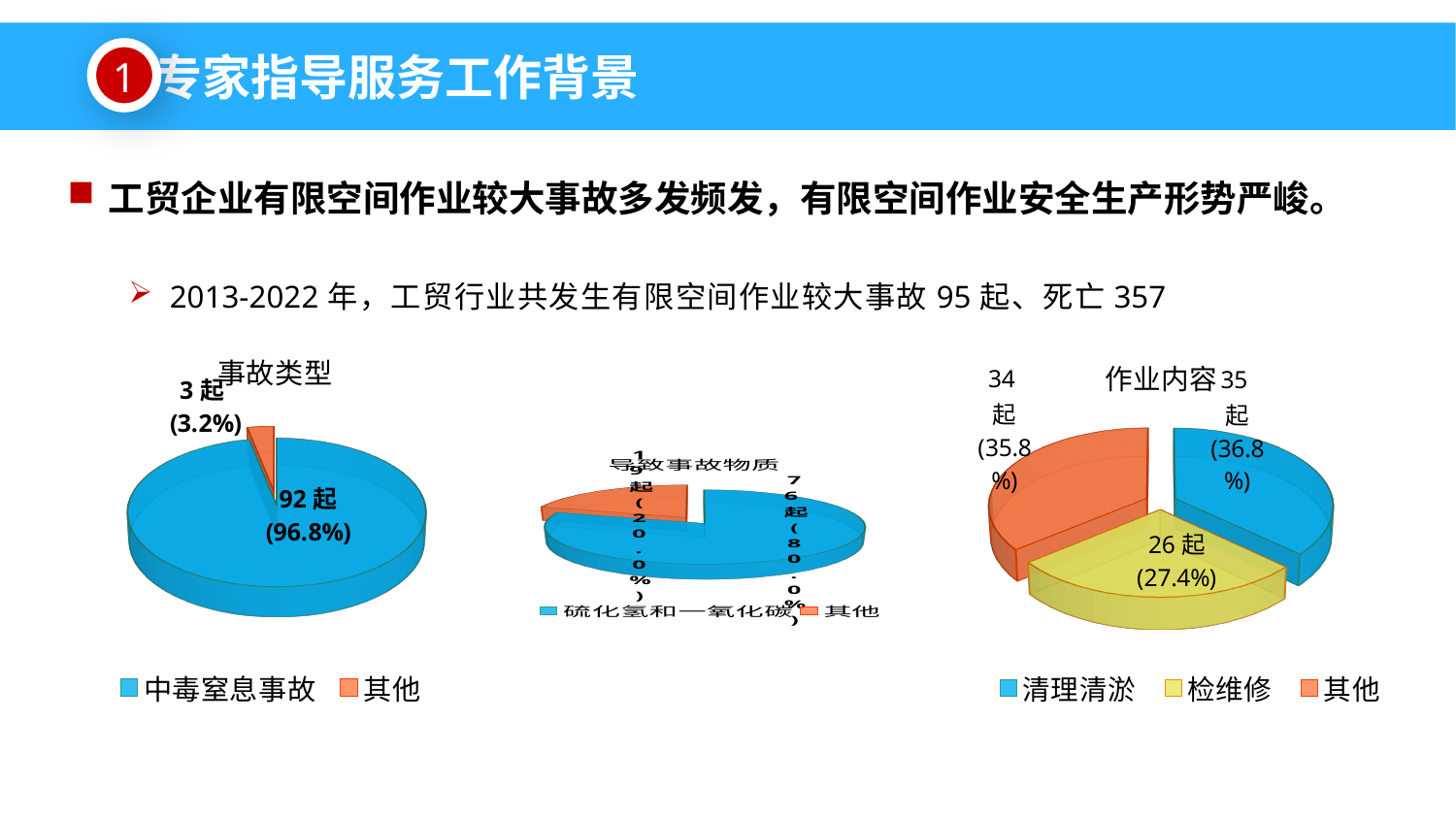
In the '作业内容' chart, which category has the smallest slice? 检维修 In the '导致事故物质' chart, what share of the pie does 硫化氢和一氧化碳 represent? 80.0% In the '作业内容' chart, what is the difference in incident count between 清理清淤 and 检维修? 9 起 In the '事故类型' chart, how many incidents are attributed to 中毒窒息事故? 92 起 What kind of chart is the '作业内容' chart? Pie chart In the '作业内容' chart, how many incidents are attributed to 检维修? 26 起 In the '事故类型' chart, what is the difference in incident count between 中毒窒息事故 and 其他? 89 起 In the '导致事故物质' chart, which category has the larger slice? 硫化氢和一氧化碳 In the '事故类型' chart, what share of the pie does 其他 represent? 3.2% In the '作业内容' chart, what share of the pie does 清理清淤 represent? 36.8% In the '事故类型' chart, which category has the largest slice? 中毒窒息事故 In the '作业内容' chart, how many categories does the legend list? 3